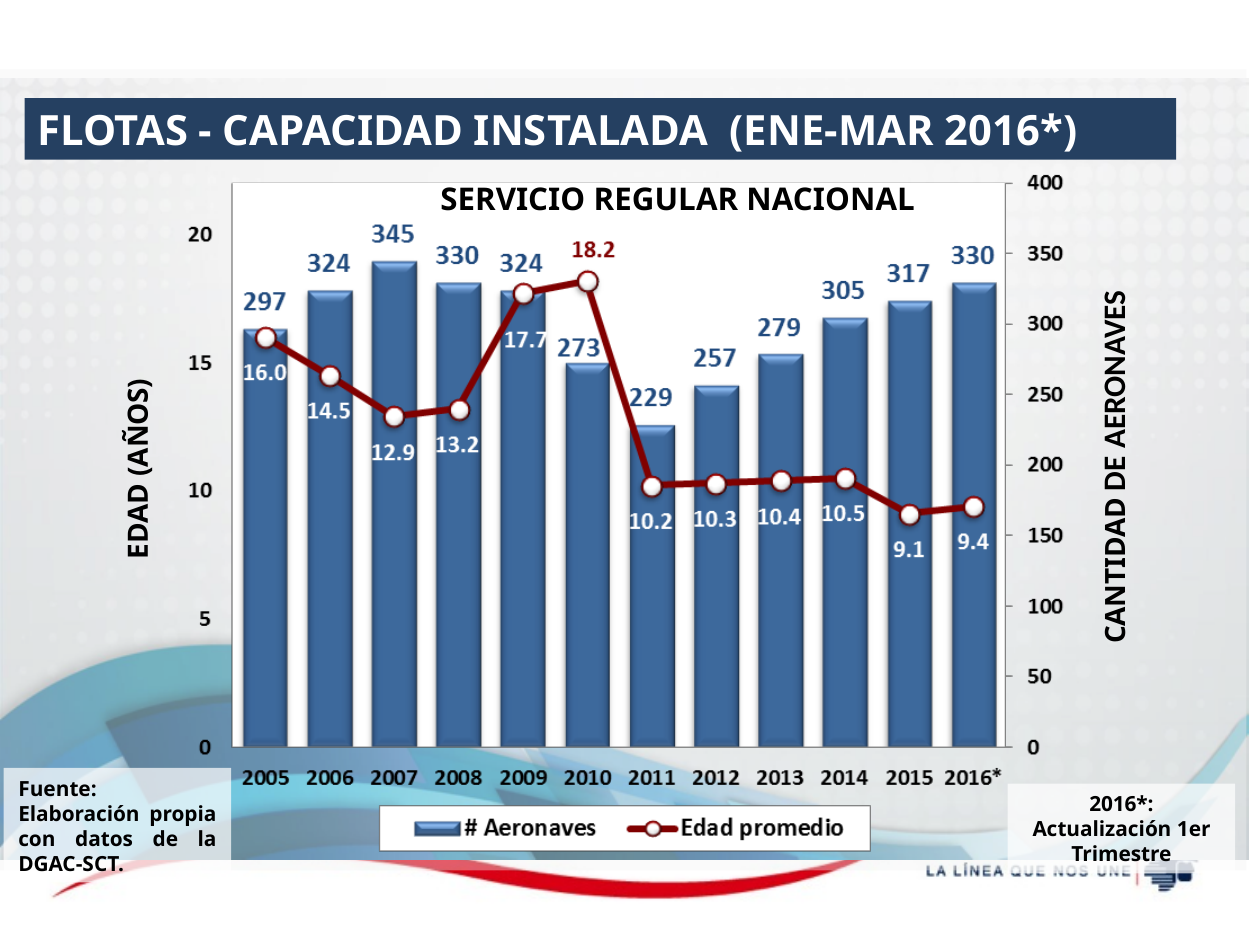
Which year has more aircraft, 2014 or 2016*? 2016* How many years are shown on the x axis? 12 Which year has the lowest number of aircraft? 2011 What is the number of aircraft (# Aeronaves) in 2007? 345 How many series does the legend list? 2 What is the title of the chart? SERVICIO REGULAR NACIONAL What is the difference in the number of aircraft between 2007 and 2011? 116 Does the average age (Edad promedio) rise or fall from 2010 to 2011? Fall Which year has the lowest average age (Edad promedio)? 2015 What is the average age (Edad promedio) in 2010? 18.2 What kinds of chart are combined on this slide? Bar chart and line chart Which year has the highest number of aircraft? 2007